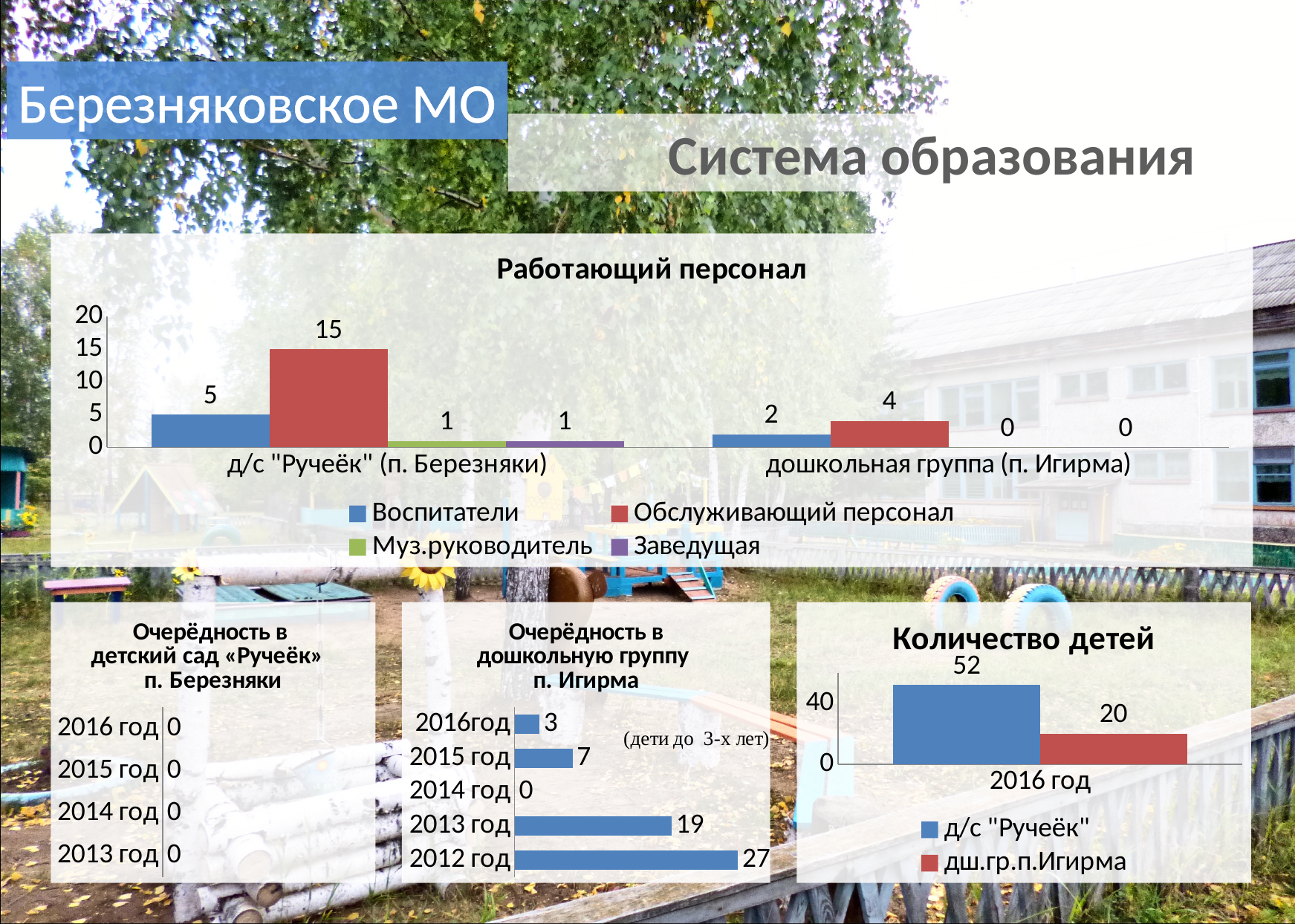
In the "Работающий персонал" chart, what is the value for Воспитатели at дошкольная группа (п. Игирма)? 2 In the "Количество детей" chart, what is the difference between д/с "Ручеёк" and дш.гр.п.Игирма in 2016 год? 32 What kind of chart is "Работающий персонал"? bar chart In the "Работающий персонал" chart, which series has the highest value at д/с "Ручеёк" (п. Березняки)? Обслуживающий персонал In the "Очерёдность в дошкольную группу п. Игирма" chart, which is larger: 2015 год or 2016 год? 2015 год In the "Количество детей" chart, what is the value for дш.гр.п.Игирма in 2016 год? 20 In the "Очерёдность в дошкольную группу п. Игирма" chart, which year has the lowest value? 2014 год How many series does the legend of the "Работающий персонал" chart list? 4 How many years are shown in the "Очерёдность в детский сад «Ручеёк» п. Березняки" chart? 4 In the "Очерёдность в дошкольную группу п. Игирма" chart, what is the value for 2012 год? 27 In the "Работающий персонал" chart, what is the difference between Обслуживающий персонал at д/с "Ручеёк" (п. Березняки) and at дошкольная группа (п. Игирма)? 11 In the "Работающий персонал" chart, what is the value for Обслуживающий персонал at д/с "Ручеёк" (п. Березняки)? 15